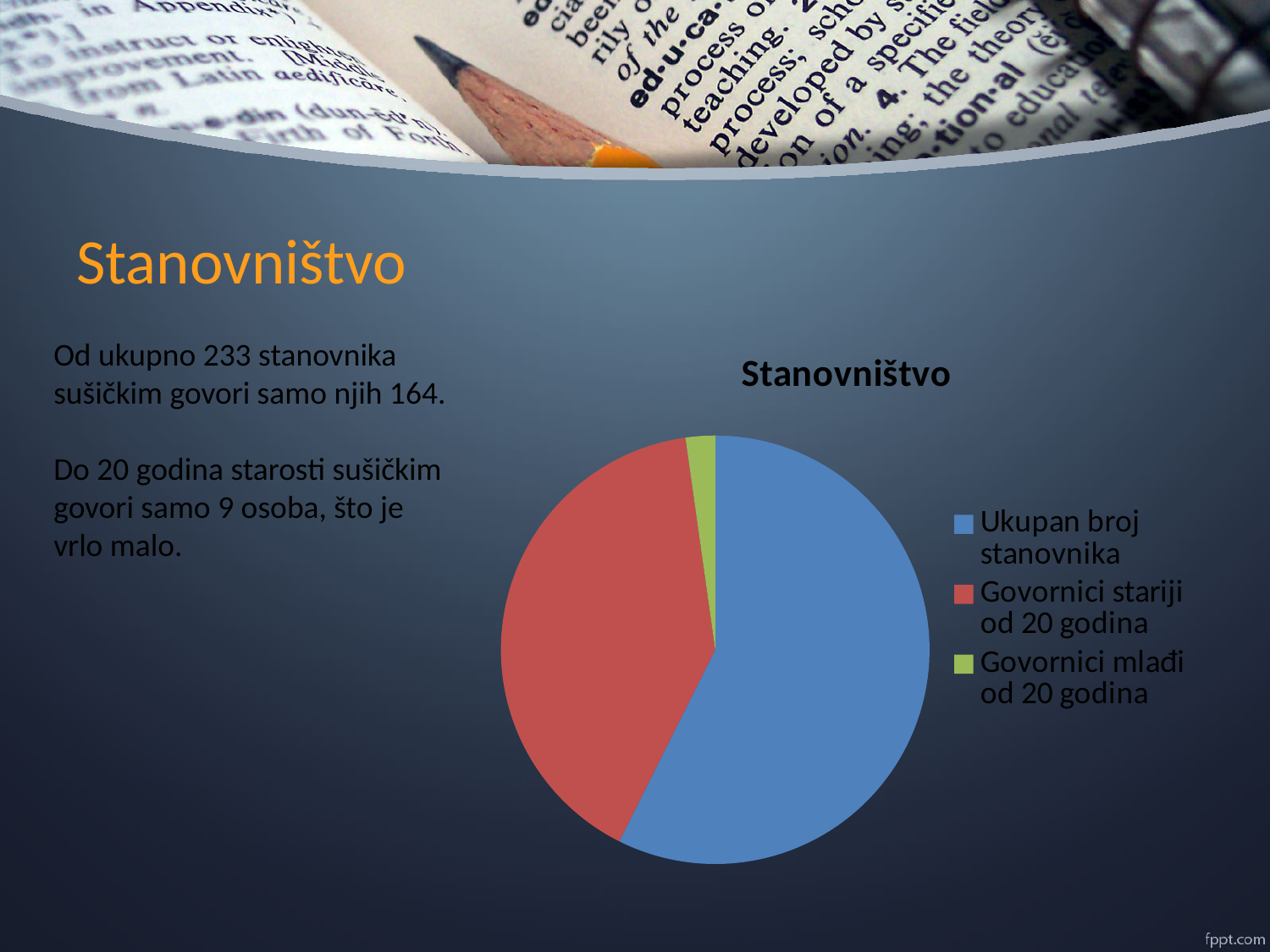
Which slice is larger: Ukupan broj stanovnika or Govornici stariji od 20 godina? Ukupan broj stanovnika Which category has the largest slice of the pie? Ukupan broj stanovnika Which category has the smallest slice of the pie? Govornici mlađi od 20 godina What is the title of the chart? Stanovništvo How many slices does the pie chart have? 3 What colour is the slice for Govornici mlađi od 20 godina? green How many entries does the chart legend list? 3 What kind of chart is shown on the slide? pie chart Which slice is larger: Govornici stariji od 20 godina or Govornici mlađi od 20 godina? Govornici stariji od 20 godina